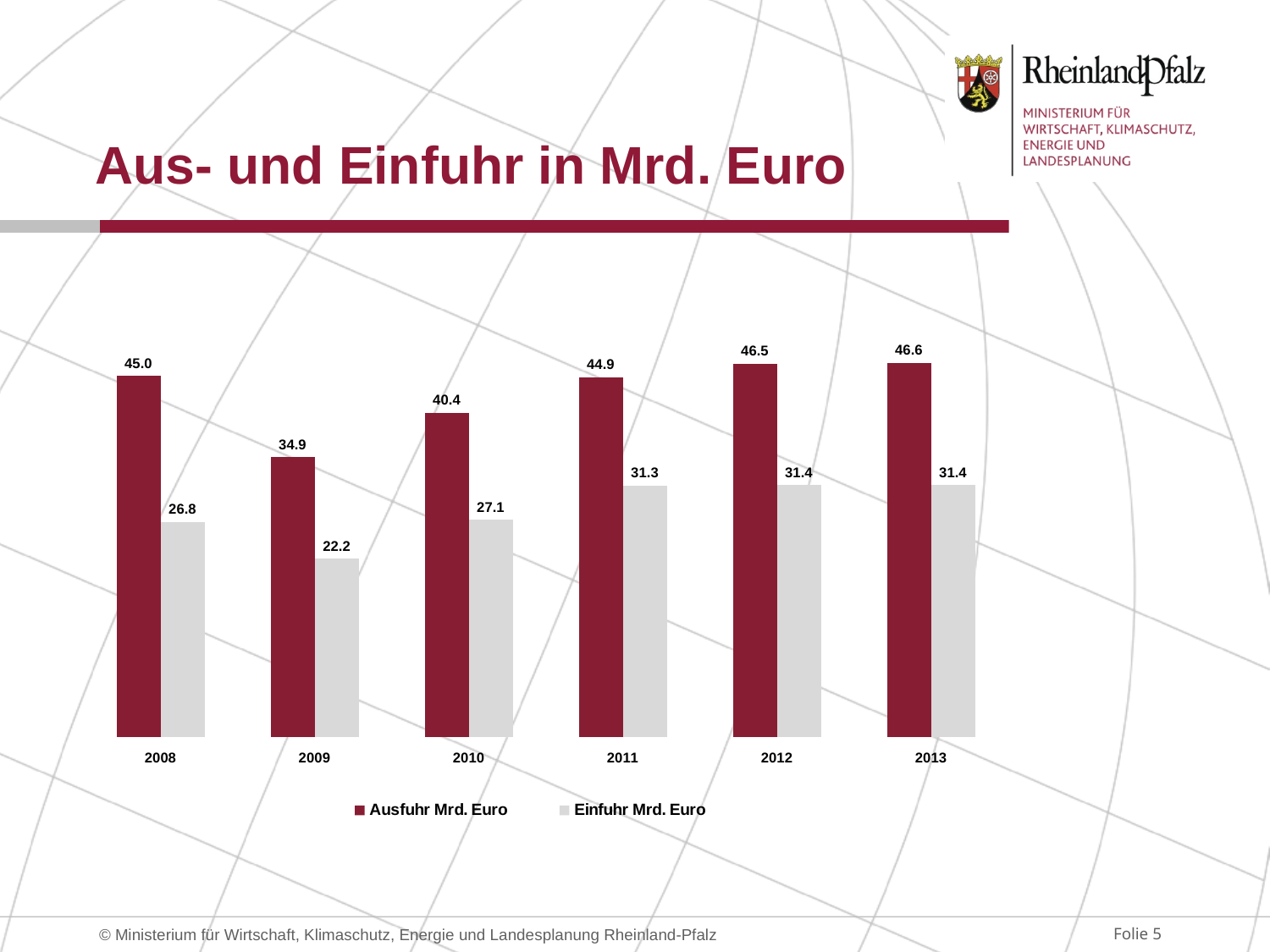
In which year is the Ausfuhr value lowest? 2009 What is the Einfuhr value for 2011? 31.3 Which is larger, the Ausfuhr value for 2010 or for 2011? 2011 In which year is the Einfuhr value lowest? 2009 What is the difference between Ausfuhr and Einfuhr in 2008? 18.2 What is the Ausfuhr value for 2008? 45.0 By how much did Ausfuhr fall from 2008 to 2009? 10.1 What kind of chart is shown on the slide? bar chart How many series does the legend list? 2 What is the Einfuhr value for 2009? 22.2 What is the Ausfuhr value for 2010? 40.4 How many years are shown on the x axis? 6